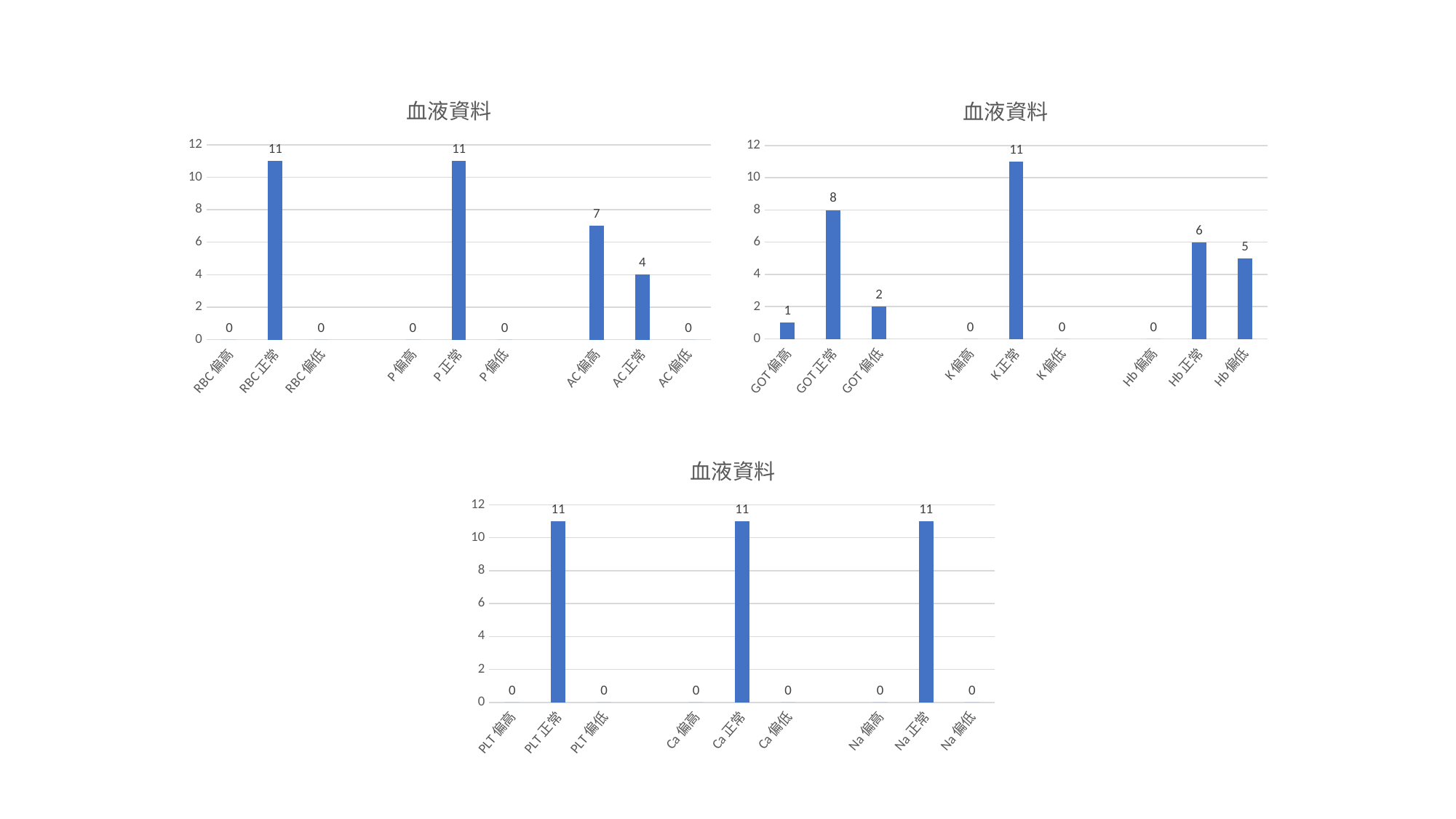
What type of chart is the bottom chart? Bar chart In the top-right chart, what is the value for Hb 偏低? 5 What is the title of the top-right chart? 血液資料 In the bottom chart, what is the value for Ca 正常? 11 In the top-left chart, what is the value for AC 正常? 4 In the top-left chart, what is the difference between AC 偏高 and AC 正常? 3 In the top-left chart, what is the value for AC 偏高? 7 In the top-right chart, what is the value for GOT 正常? 8 In the top-right chart, what is the difference between GOT 正常 and GOT 偏低? 6 How many categories are shown in the bottom chart? 9 In the top-right chart, which is larger, Hb 正常 or Hb 偏低? Hb 正常 In the top-right chart, which category has the highest value? K 正常